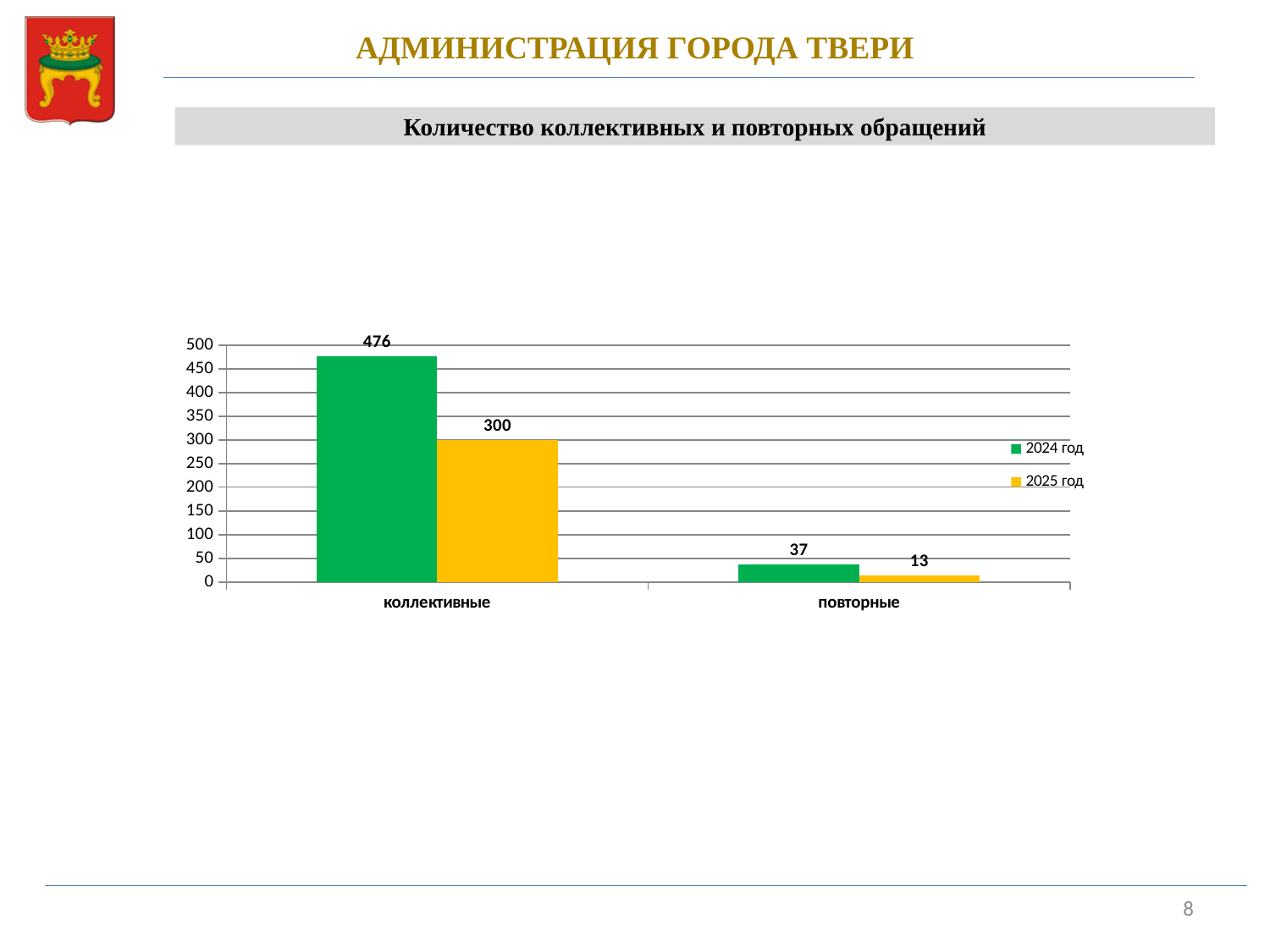
What is the value for повторные in the 2024 год series? 37 Which is larger for коллективные: the 2024 год value or the 2025 год value? 2024 год What is the difference between the 2024 год and 2025 год values for коллективные? 176 How many series does the legend list? 2 Which category has the highest value in the 2024 год series? коллективные What is the value for коллективные in the 2025 год series? 300 What is the difference between the 2024 год and 2025 год values for повторные? 24 What is the value for повторные in the 2025 год series? 13 Which category has the lowest value in the 2025 год series? повторные What is the value for коллективные in the 2024 год series? 476 What kind of chart is shown on the slide? bar chart How many categories are shown on the x axis? 2